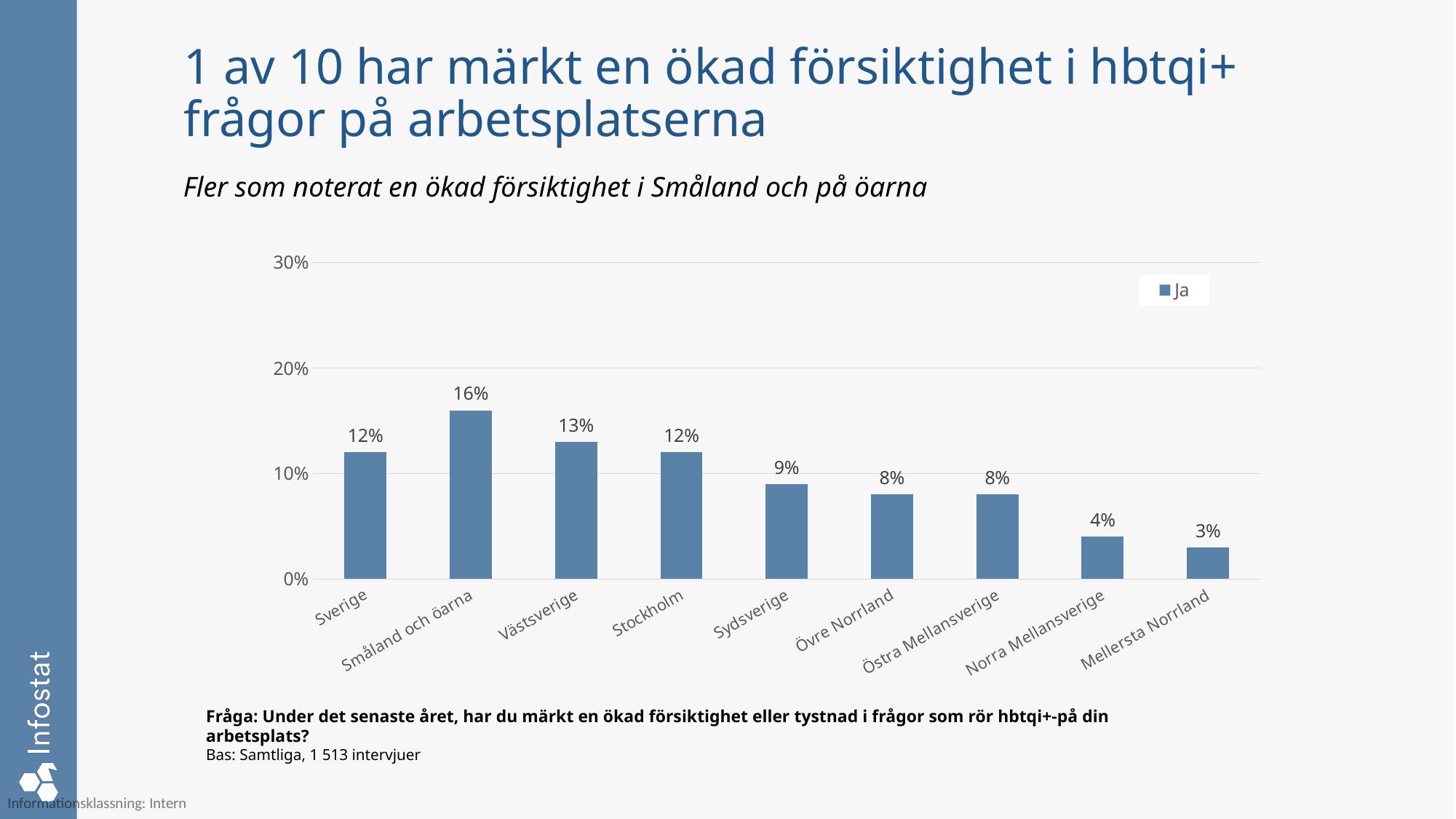
Which is larger, the value for Västsverige or the value for Sydsverige? Västsverige What is the legend entry for the series? Ja Is the value for Norra Mellansverige greater or less than 10%? less What is the difference between the values for Småland och öarna and Sverige? 4% What kind of chart is shown on the slide? bar chart Which category has the highest value? Småland och öarna Which category has the lowest value? Mellersta Norrland What is the value for Småland och öarna? 16% What is the value for Mellersta Norrland? 3% How many series does the legend list? 1 How many categories are shown on the x axis? 9 What is the value for Stockholm? 12%